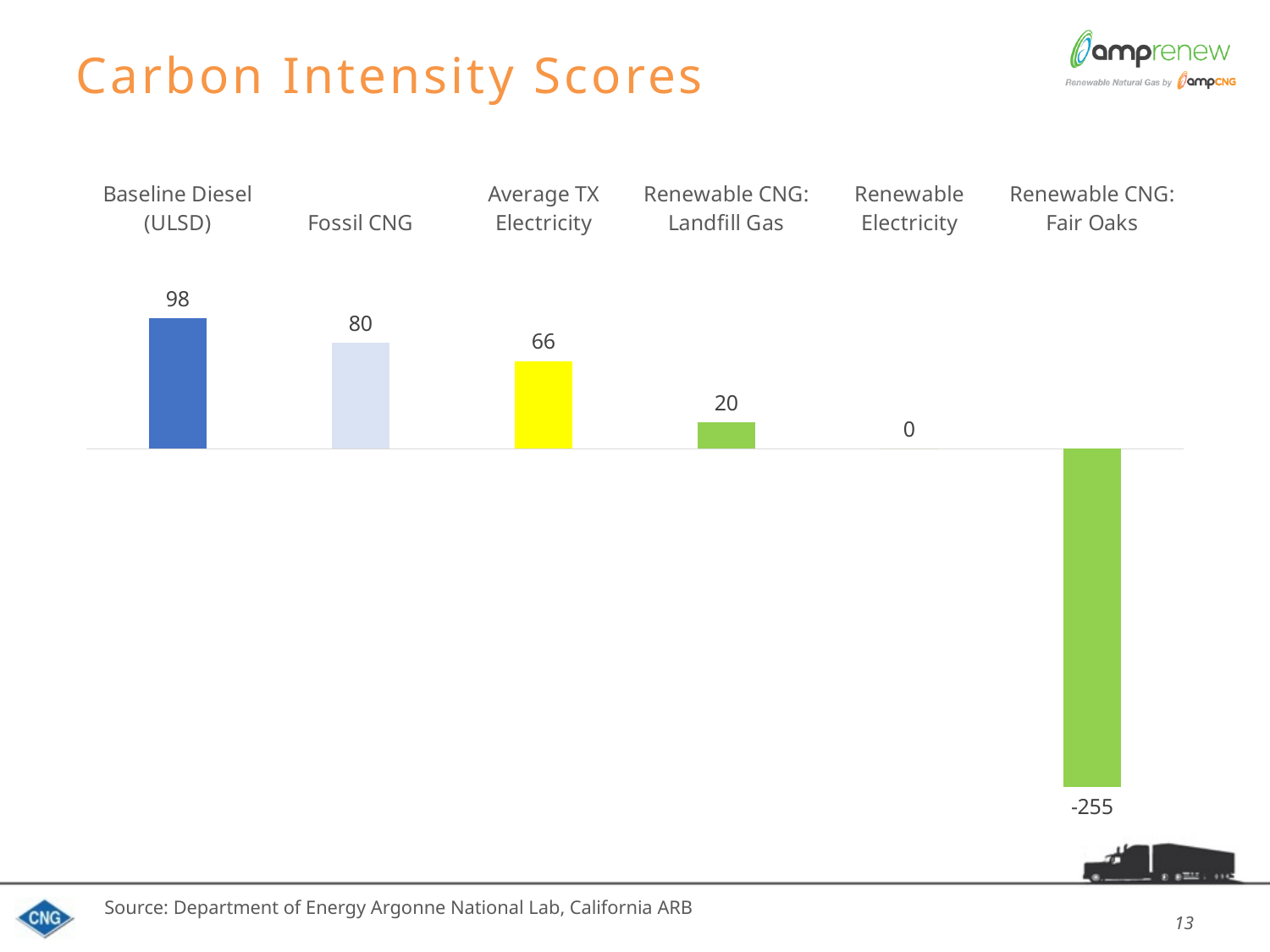
What is the carbon intensity score for Baseline Diesel (ULSD)? 98 Which category has the highest carbon intensity score? Baseline Diesel (ULSD) What is the title of the chart on the slide? Carbon Intensity Scores What is the carbon intensity score for Renewable CNG: Landfill Gas? 20 What kind of chart is shown on the slide? Bar chart What is the difference between the carbon intensity scores of Baseline Diesel (ULSD) and Fossil CNG? 18 Which category has the lowest carbon intensity score? Renewable CNG: Fair Oaks What is the carbon intensity score for Average TX Electricity? 66 Which has a higher carbon intensity score, Average TX Electricity or Renewable CNG: Landfill Gas? Average TX Electricity How many categories are shown in the chart? 6 What is the carbon intensity score for Fossil CNG? 80 What is the carbon intensity score for Renewable CNG: Fair Oaks? -255